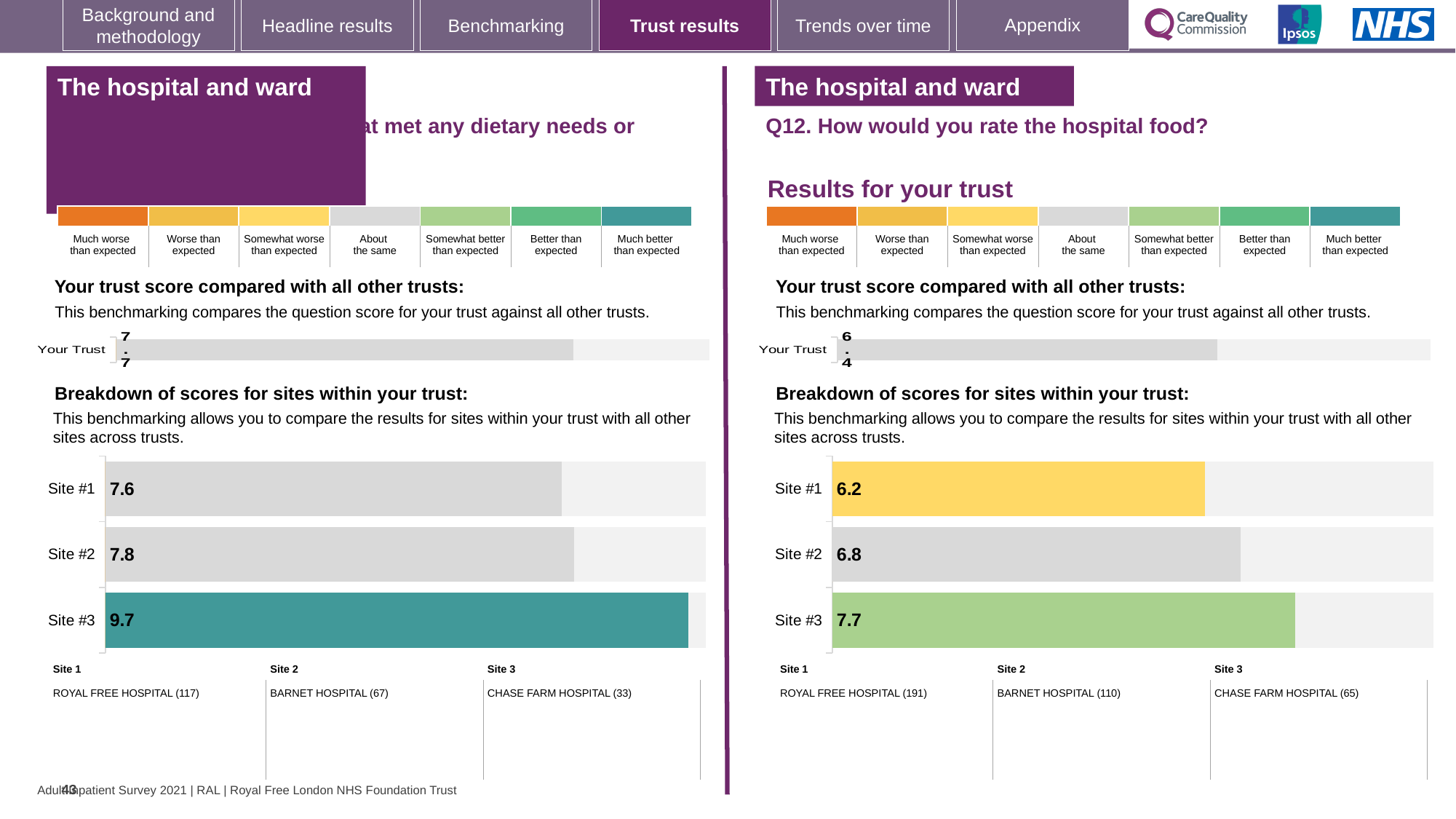
In the right-hand site breakdown chart for Q12, which benchmark category does the colour of the Site #1 bar correspond to? Somewhat worse than expected In the right-hand site breakdown chart for Q12, which site has the larger score, Site #2 or Site #3? Site #3 In the left-hand site breakdown chart, what is the score for Site #3? 9.7 In the right-hand 'Your trust score compared with all other trusts' chart for Q12, what is the score for Your Trust? 6.4 In the right-hand site breakdown chart for Q12, what is the difference between the scores for Site #3 and Site #1? 1.5 What type of chart is used for the site breakdown on the right-hand side of the slide? Bar chart In the left-hand site breakdown chart, what is the difference between the scores for Site #3 and Site #2? 1.9 In the right-hand site breakdown chart (Q12, hospital food), what is the score for Site #1? 6.2 In the left-hand site breakdown chart, which site has the highest score? Site #3 How many sites are shown in the right-hand site breakdown chart for Q12? 3 In the right-hand site breakdown chart for Q12, which site has the lowest score? Site #1 In the left-hand 'Your trust score compared with all other trusts' chart, what is the score for Your Trust? 7.7